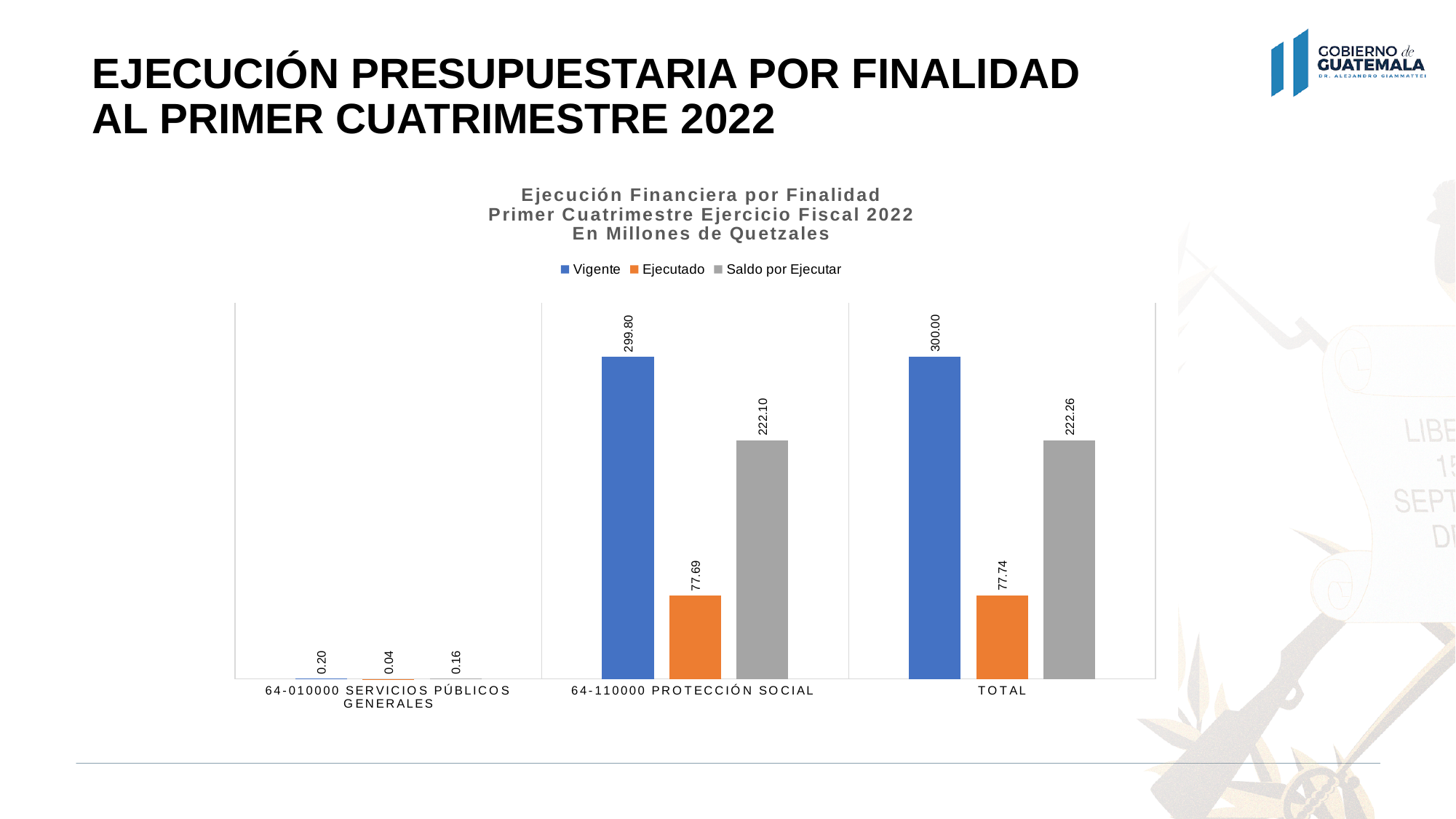
What kind of chart is shown on the slide? Bar chart How many categories are shown on the x axis? 3 What is the difference between the Saldo por Ejecutar values for Total and 64-110000 Protección Social? 0.16 Which category has the highest Vigente value? Total Which category has the lowest Ejecutado value? 64-010000 Servicios Públicos Generales What is the Saldo por Ejecutar value for 64-010000 Servicios Públicos Generales? 0.16 What is the Ejecutado value for Total? 77.74 What is the Ejecutado value for 64-010000 Servicios Públicos Generales? 0.04 What is the Vigente value for 64-110000 Protección Social? 299.80 For 64-110000 Protección Social, which is larger: Ejecutado or Saldo por Ejecutar? Saldo por Ejecutar How many series does the legend list? 3 What is the difference between the Vigente and Ejecutado values for Total? 222.26